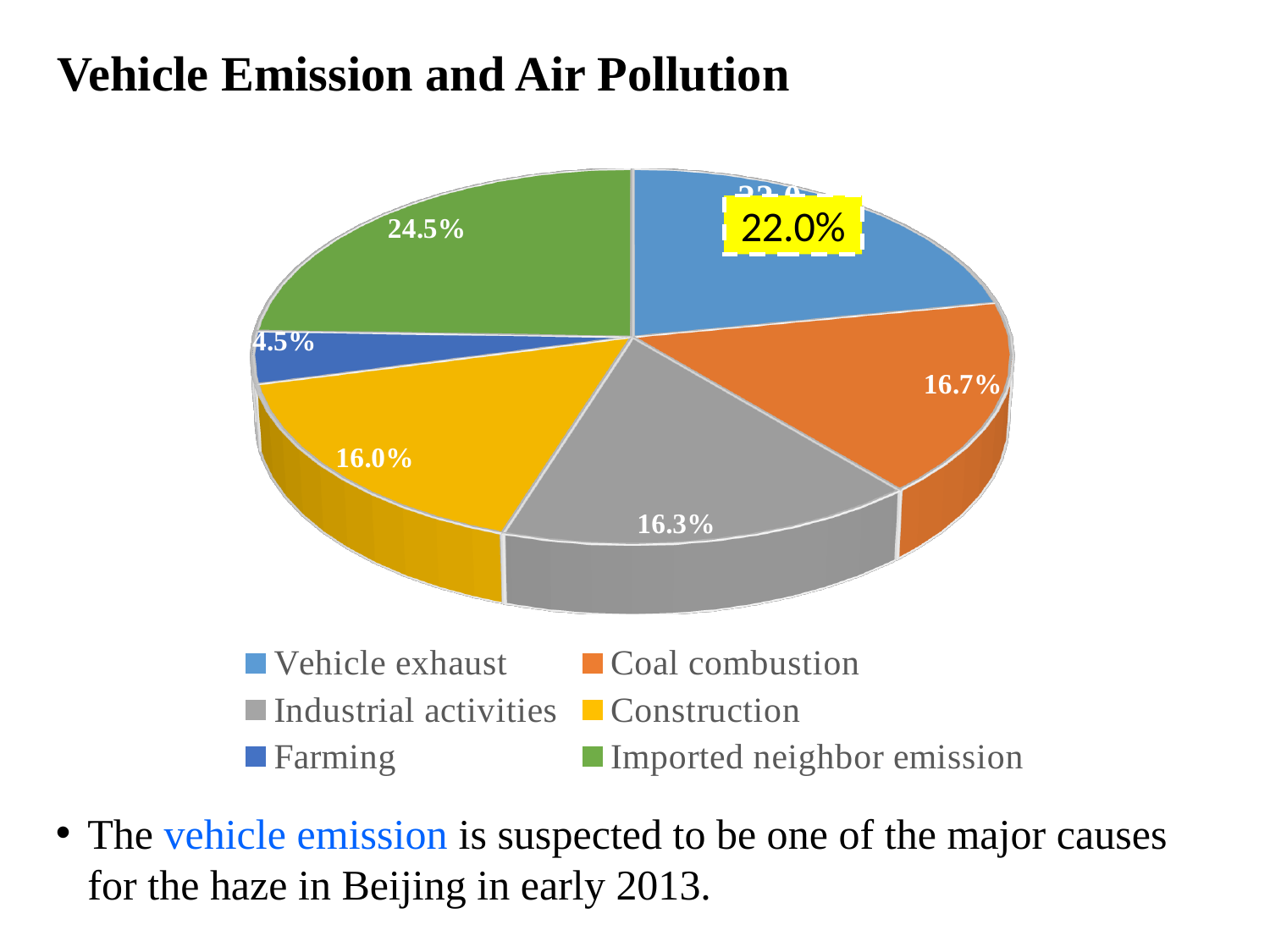
How many categories does the legend list? 6 What is the value shown for Construction? 16.0% What share of the pie does Vehicle exhaust account for? 22.0% What is the value shown for Industrial activities? 16.3% What is the difference between the Imported neighbor emission share and the Vehicle exhaust share? 2.5% Which category has the largest slice of the pie? Imported neighbor emission What is the value shown for Farming? 4.5% What kind of chart is shown on the slide? pie chart Which category has the smallest slice of the pie? Farming What is the value shown for Imported neighbor emission? 24.5% What is the value shown for Coal combustion? 16.7% Which is larger, the share for Vehicle exhaust or the share for Coal combustion? Vehicle exhaust